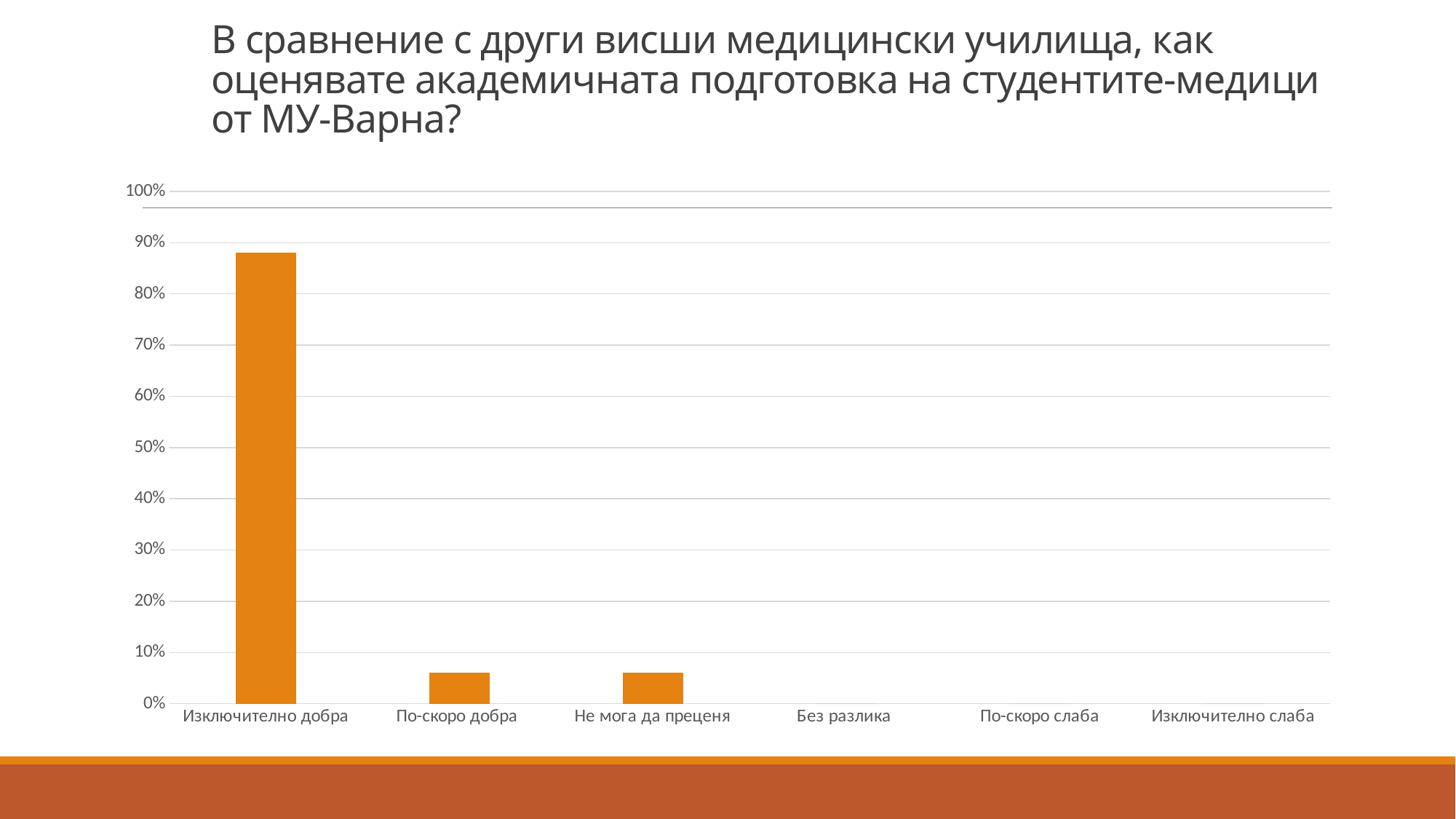
What colour are the bars in the chart? orange Is the value for Не мога да преценя greater or less than 10%? less Is the value for Изключително добра greater or less than 80%? greater Is the value for По-скоро добра greater or less than 10%? less What is the highest value shown on the y axis of the chart? 100% Which category has the highest value in the chart? Изключително добра What kind of chart is shown on the slide? bar chart How many categories are shown on the x axis of the chart? 6 What is the label of the first category on the x axis? Изключително добра Which is larger, the value for Изключително добра or the value for По-скоро добра? Изключително добра Which is larger, the value for Не мога да преценя or the value for Без разлика? Не мога да преценя